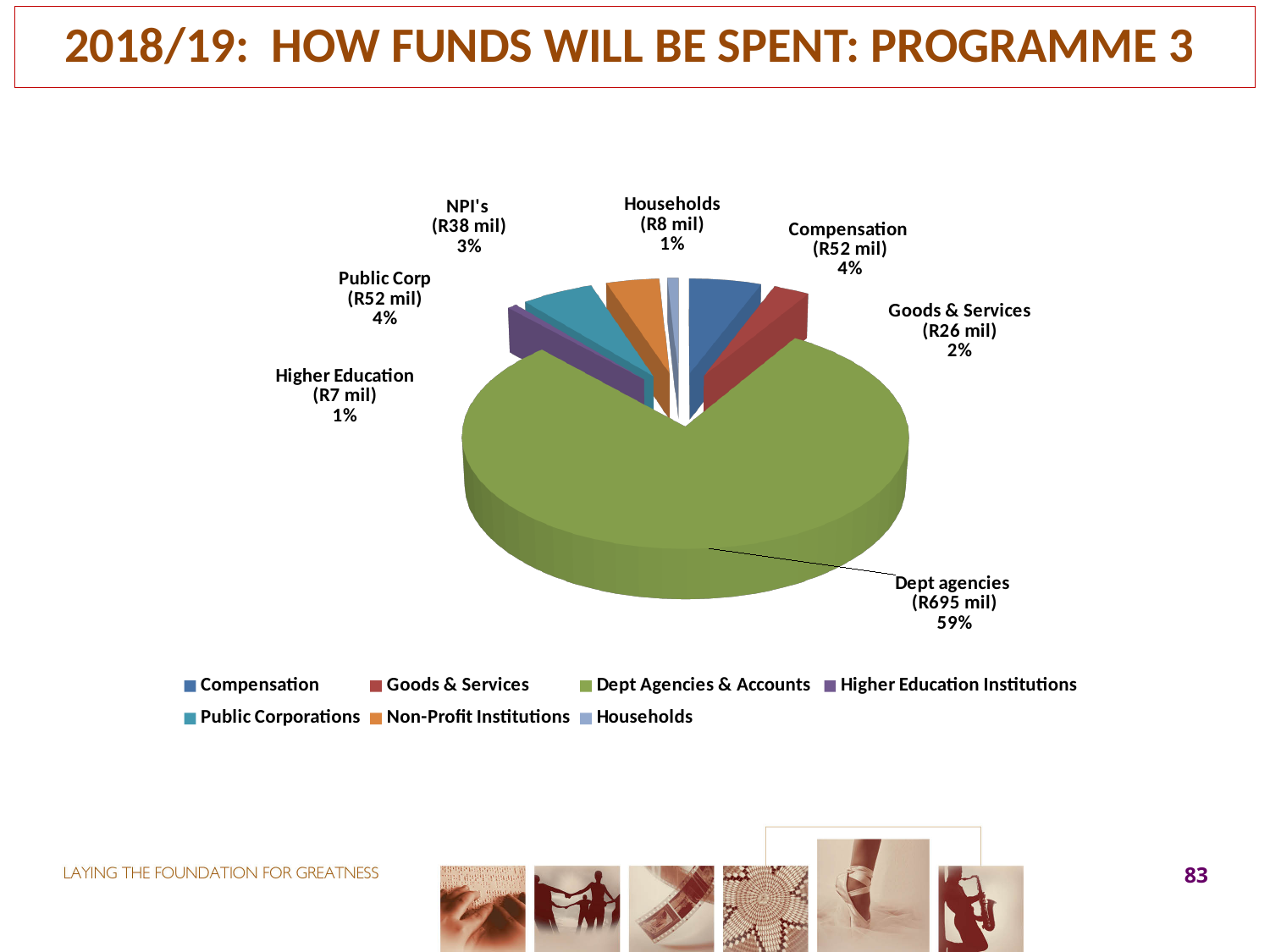
What is the title of the slide? 2018/19: HOW FUNDS WILL BE SPENT: PROGRAMME 3 Which category has the smallest amount? Higher Education What amount is shown for Dept agencies? R695 mil What percentage share is shown for Dept agencies? 59% What kind of chart is shown on the slide? Pie chart What amount is shown for NPI's? R38 mil What is the difference in amount between Dept agencies and Compensation? R643 mil What percentage share is shown for Public Corp? 4% Which category has the largest amount? Dept agencies Which is larger, the amount for Goods & Services or the amount for NPI's? NPI's How many categories are shown in the pie chart? 7 How many entries does the legend list? 7